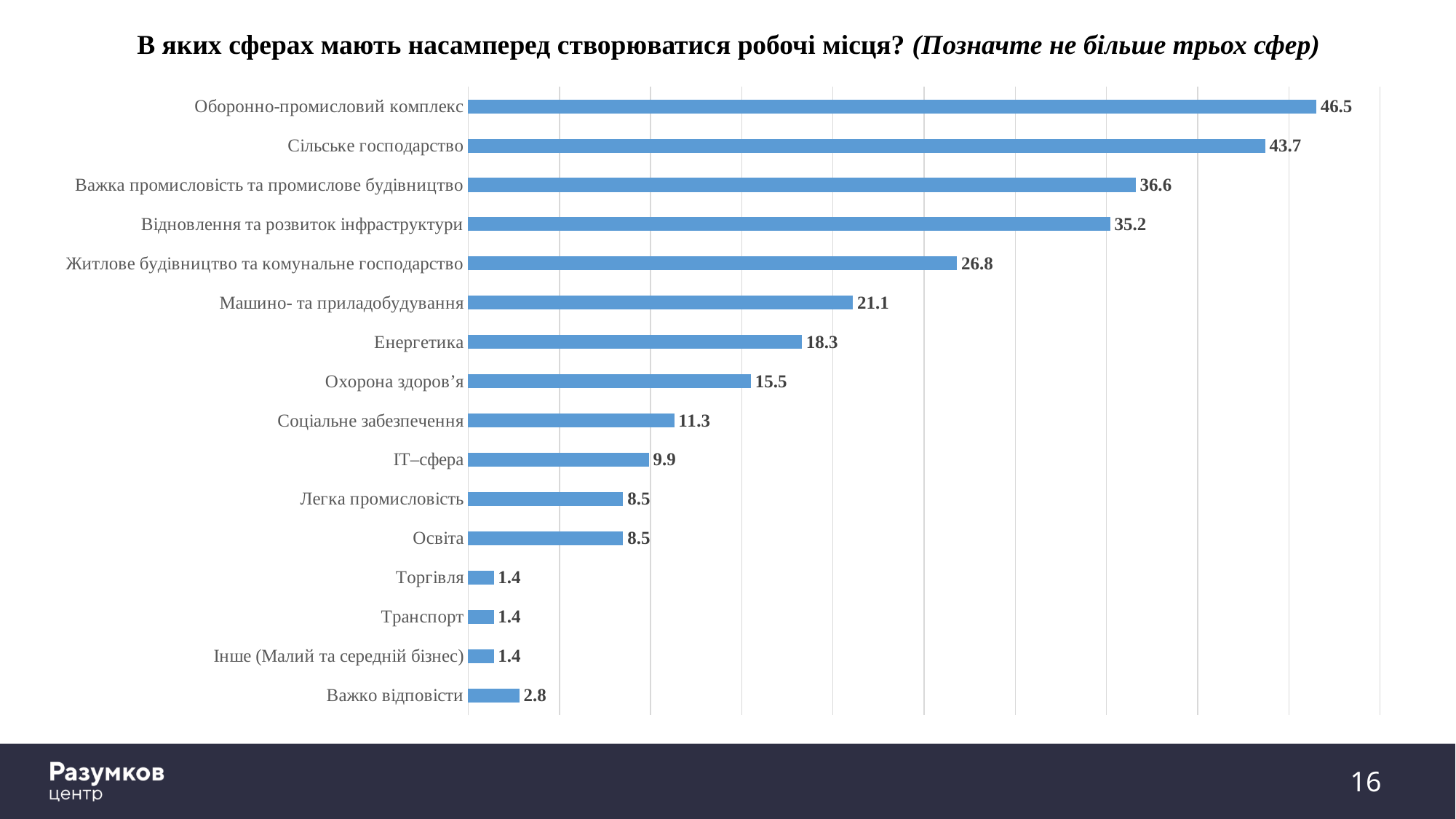
What is the difference between the values for Сільське господарство and Важка промисловість та промислове будівництво? 7.1 What is the value for Відновлення та розвиток інфраструктури? 35.2 Which is larger, the value for IT–сфера or the value for Освіта? IT–сфера How many categories have a value of 1.4? 3 What kind of chart is shown on the slide? Bar chart Which category has the highest value? Оборонно-промисловий комплекс What is the value for Оборонно-промисловий комплекс? 46.5 How many categories are shown in the chart? 16 What is the difference between the values for Охорона здоров’я and Соціальне забезпечення? 4.2 What is the value for Енергетика? 18.3 What is the value for Важко відповісти? 2.8 Which is larger, the value for Житлове будівництво та комунальне господарство or the value for Машино- та приладобудування? Житлове будівництво та комунальне господарство